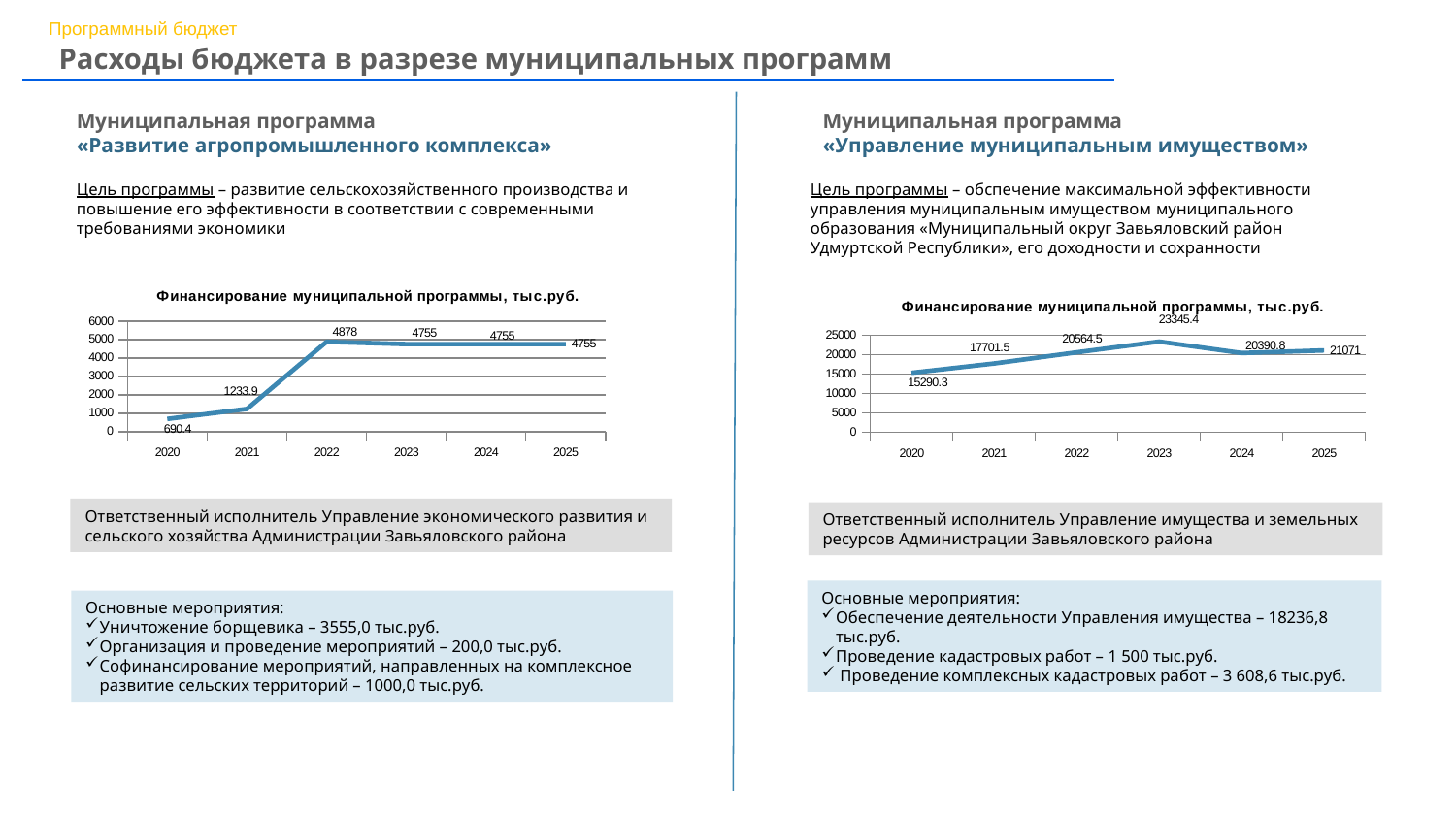
On the right chart (program «Управление муниципальным имуществом»), which is larger, the value for 2024 or the value for 2025? 2025 On the left chart (program «Развитие агропромышленного комплекса»), what is the value for 2022? 4878 On the left chart (program «Развитие агропромышленного комплекса»), what is the difference between the 2022 and 2023 values? 123 On the left chart (program «Развитие агропромышленного комплекса»), which year has the highest value? 2022 On the left chart (program «Развитие агропромышленного комплекса»), which year has the lowest value? 2020 What type of chart is used on the right side of the slide (program «Управление муниципальным имуществом»)? Line chart On the right chart (program «Управление муниципальным имуществом»), which year has the highest value? 2023 On the right chart (program «Управление муниципальным имуществом»), what is the value for 2023? 23345.4 On the right chart (program «Управление муниципальным имуществом»), what is the difference between the 2021 and 2020 values? 2411.2 On the left chart (program «Развитие агропромышленного комплекса»), what is the value for 2020? 690.4 On the right chart (program «Управление муниципальным имуществом»), what is the value for 2020? 15290.3 On the left chart (program «Развитие агропромышленного комплекса»), how many years are plotted on the x axis? 6